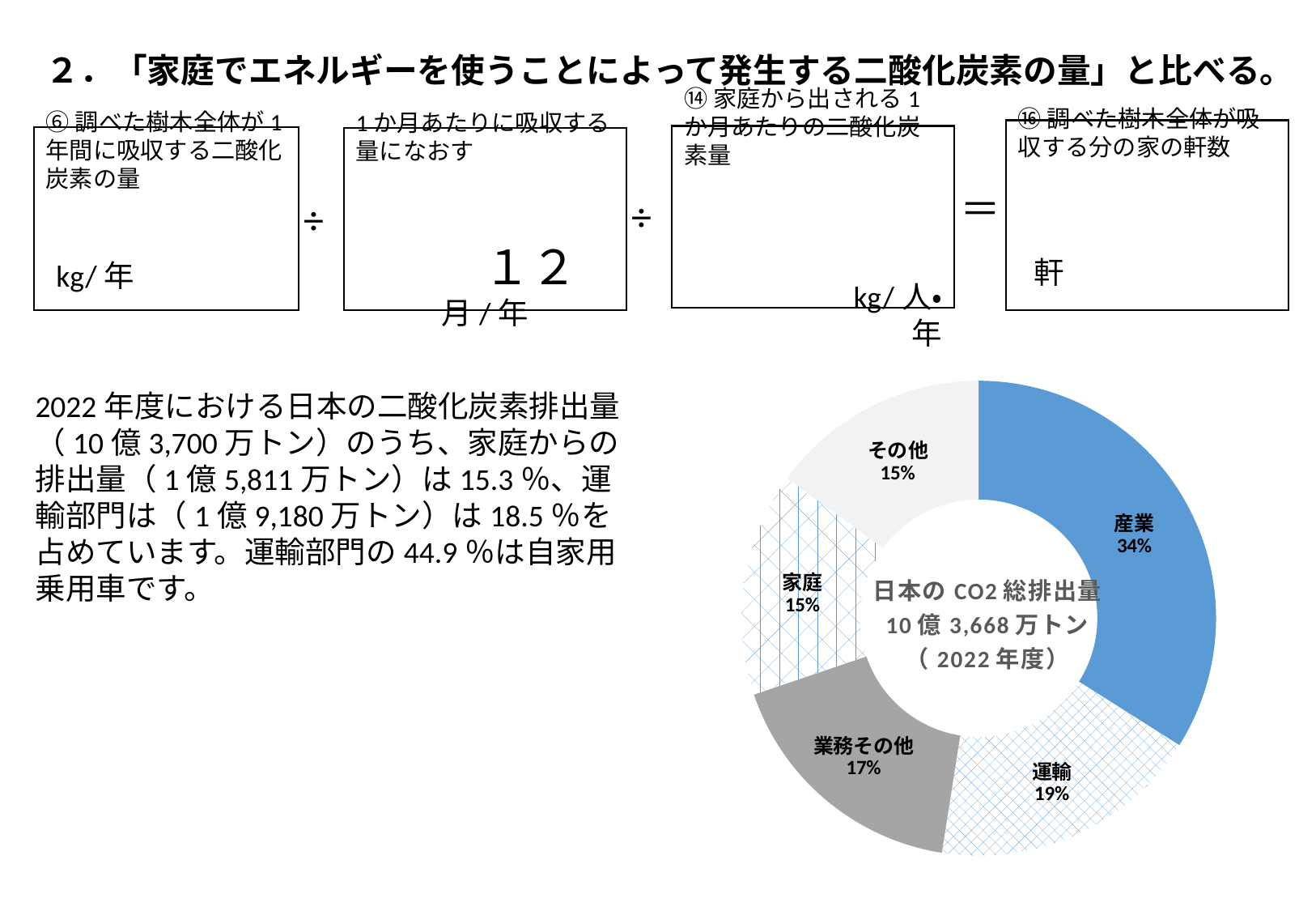
What percentage is shown for 運輸 (transport) in the doughnut chart? 19% Which sector has the largest share in the doughnut chart? 産業 What share of the doughnut chart is labelled 家庭 (households)? 15% What share of the doughnut chart does 産業 (industry) account for? 34% Which has a larger share in the doughnut chart, 業務その他 or 家庭? 業務その他 What is the difference in percentage points between 産業 and 運輸 in the doughnut chart? 15 percentage points What type of chart is shown on the slide? Doughnut (pie) chart How many sectors (slices) are shown in the doughnut chart? 5 What total CO2 emission figure is printed in the centre of the doughnut chart? 10億3,668万トン What percentage is shown for 業務その他 in the doughnut chart? 17% What is the combined share of 家庭 and その他 in the doughnut chart? 30% Which fiscal year does the doughnut chart refer to, according to its centre text? 2022年度